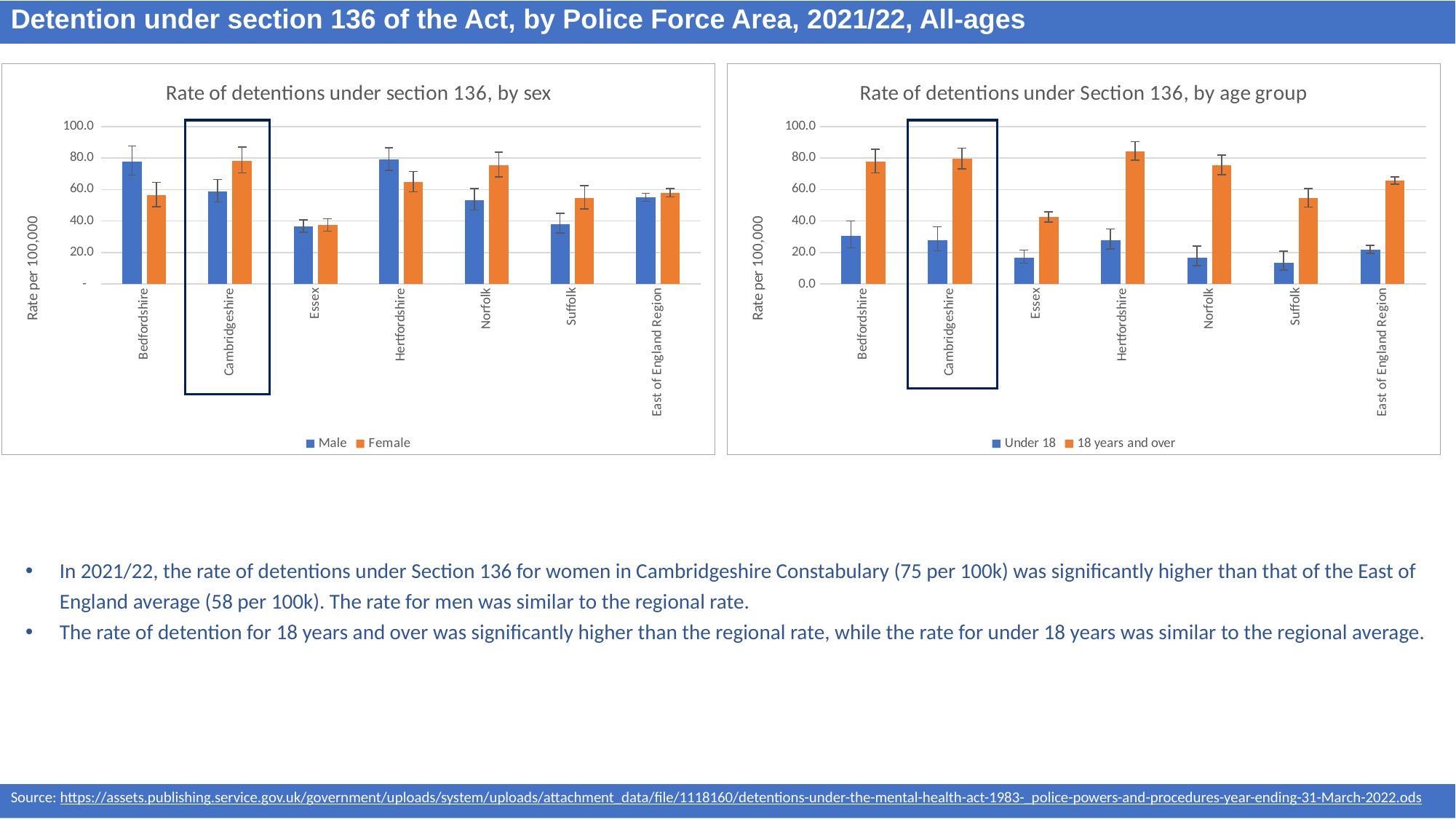
What is the y-axis label of the left chart, 'Rate of detentions under section 136, by sex'? Rate per 100,000 In the left chart, 'Rate of detentions under section 136, by sex', is the Male value for Bedfordshire greater or less than 60? greater In the left chart, 'Rate of detentions under section 136, by sex', which police force area has the lowest Female rate? Essex What are the two series named in the legend of the right chart, 'Rate of detentions under Section 136, by age group'? Under 18 and 18 years and over In the left chart, 'Rate of detentions under section 136, by sex', which is larger for Cambridgeshire, the Male or the Female rate? Female In the left chart, 'Rate of detentions under section 136, by sex', is the Male value for Essex greater or less than 40? less In the right chart, 'Rate of detentions under Section 136, by age group', which police force area has the lowest rate for 18 years and over? Essex How many police force area categories are shown on the x axis of the right chart, 'Rate of detentions under Section 136, by age group'? 7 What kind of chart is the left chart, 'Rate of detentions under section 136, by sex'? bar chart In the right chart, 'Rate of detentions under Section 136, by age group', which is larger for Hertfordshire, the Under 18 rate or the 18 years and over rate? 18 years and over How many series does the legend of the left chart, 'Rate of detentions under section 136, by sex', list? 2 In the right chart, 'Rate of detentions under Section 136, by age group', is the Under 18 value for Suffolk greater or less than 20? less